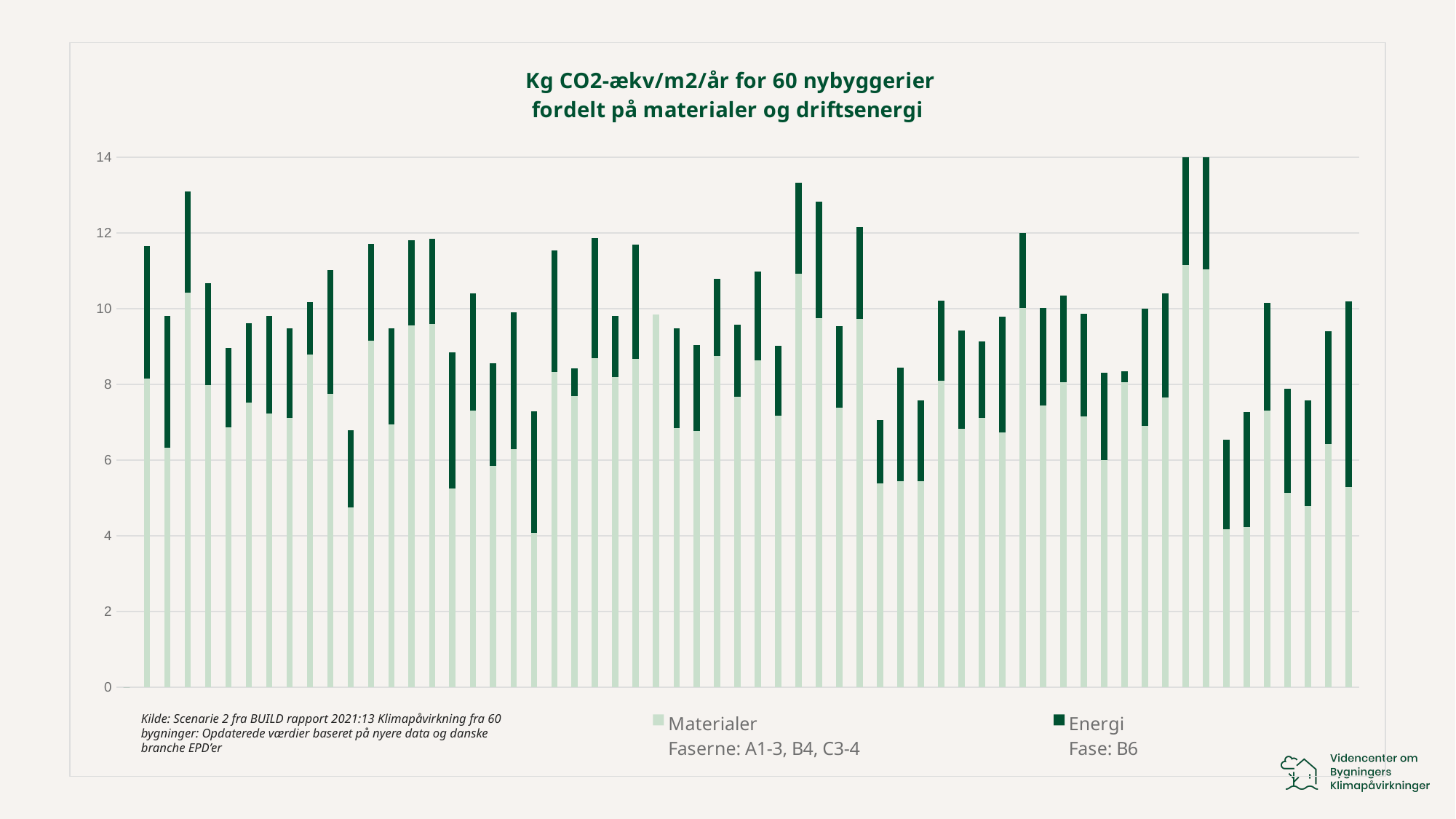
Which series is drawn in the dark green colour? Energi Is the total of the leftmost bar greater or less than 10? greater What is the highest value shown on the y axis? 14 Which series forms the bottom segment of each stacked bar? Materialer Is the Materialer portion of the leftmost bar greater or less than 6? greater How many new buildings (nybyggerier) does the chart cover according to its title? 60 How many series does the legend list? 2 What kind of chart is shown on the slide? Stacked bar chart What are the two series named in the legend? Materialer and Energi